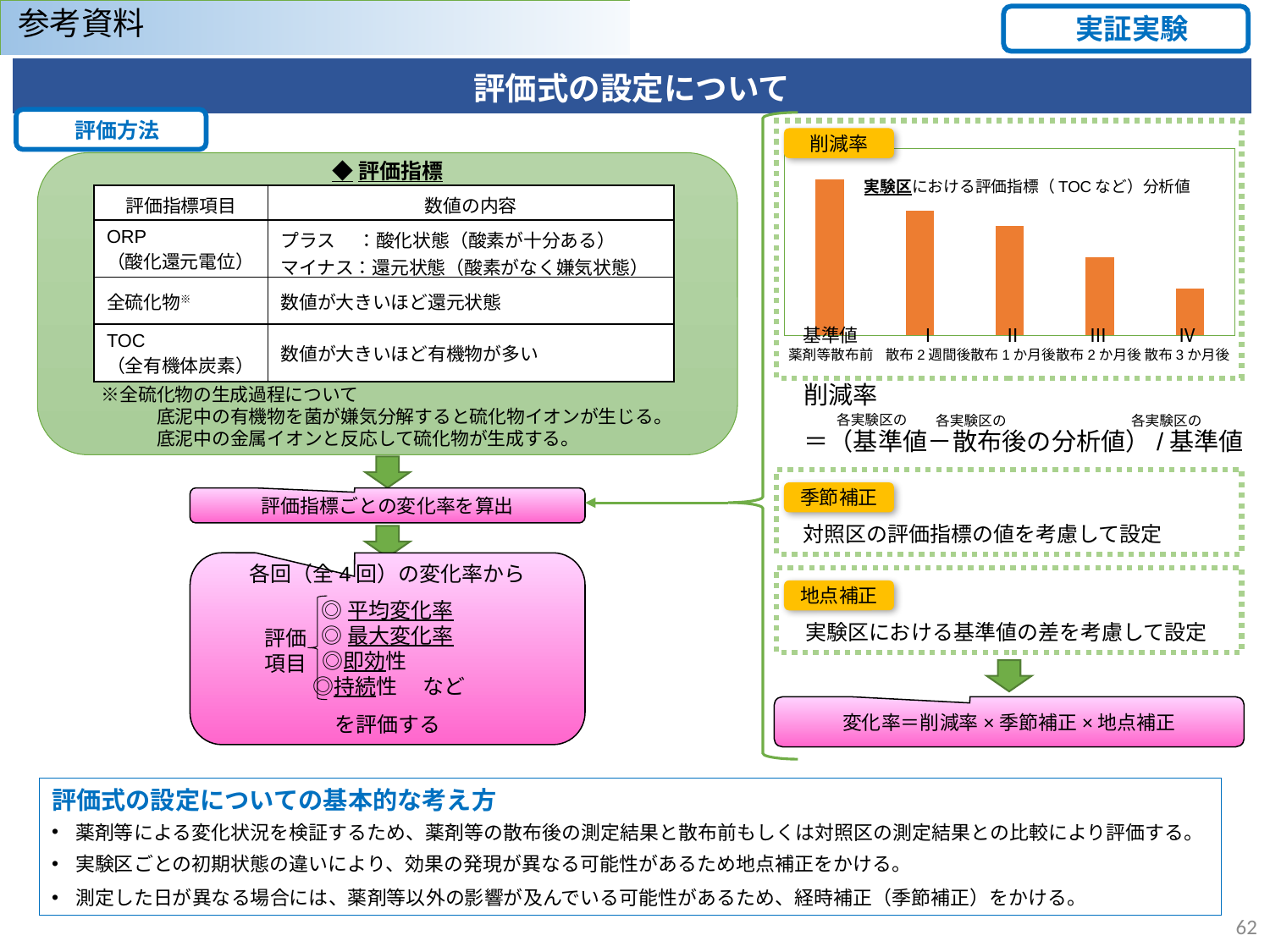
How many bars are plotted in the chart on the right of the slide? 5 In the chart on the right of the slide, which bar is taller, II or IV? II Which category has the tallest bar in the chart on the right of the slide? 基準値 In the chart on the right of the slide, which bar is taller, 基準値 or II? 基準値 What colour are the bars in the chart on the right of the slide? orange In the chart on the right of the slide, which bar is taller, I or III? I What kind of chart is shown in the 削減率 box on the right of the slide? bar chart In the chart on the right of the slide, which category label corresponds to 薬剤等散布前? 基準値 Do the bar values rise or fall from 基準値 to IV in the chart on the right of the slide? fall Which category has the shortest bar in the chart on the right of the slide? IV What is the title printed inside the chart on the right of the slide? 実験区における評価指標（TOC など）分析値